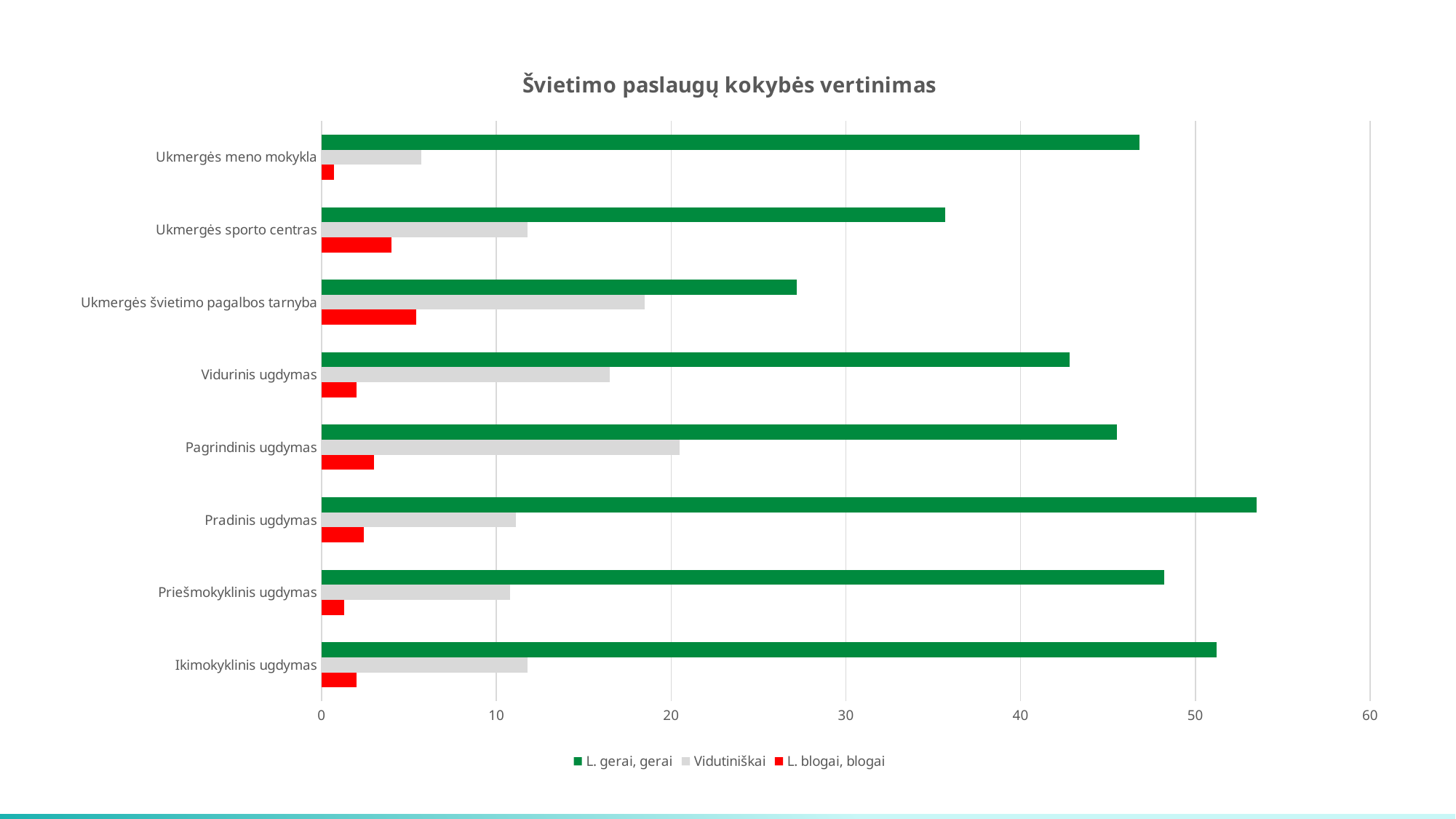
Which category has the highest value for the 'Vidutiniškai' series? Pagrindinis ugdymas Which category has the highest value for the 'L. blogai, blogai' series? Ukmergės švietimo pagalbos tarnyba Is the 'L. gerai, gerai' value for Pradinis ugdymas greater or less than 50? greater What type of chart is shown on the slide? bar chart Is the 'L. gerai, gerai' value for Ukmergės švietimo pagalbos tarnyba greater or less than 30? less What is the title of the chart? Švietimo paslaugų kokybės vertinimas Which category has the highest value for the 'L. gerai, gerai' series? Pradinis ugdymas How many series does the legend list? 3 Which has the larger 'L. gerai, gerai' value: Ukmergės meno mokykla or Ukmergės sporto centras? Ukmergės meno mokykla How many categories are shown on the vertical axis? 8 Which category has the lowest value for the 'Vidutiniškai' series? Ukmergės meno mokykla Which category has the lowest value for the 'L. gerai, gerai' series? Ukmergės švietimo pagalbos tarnyba